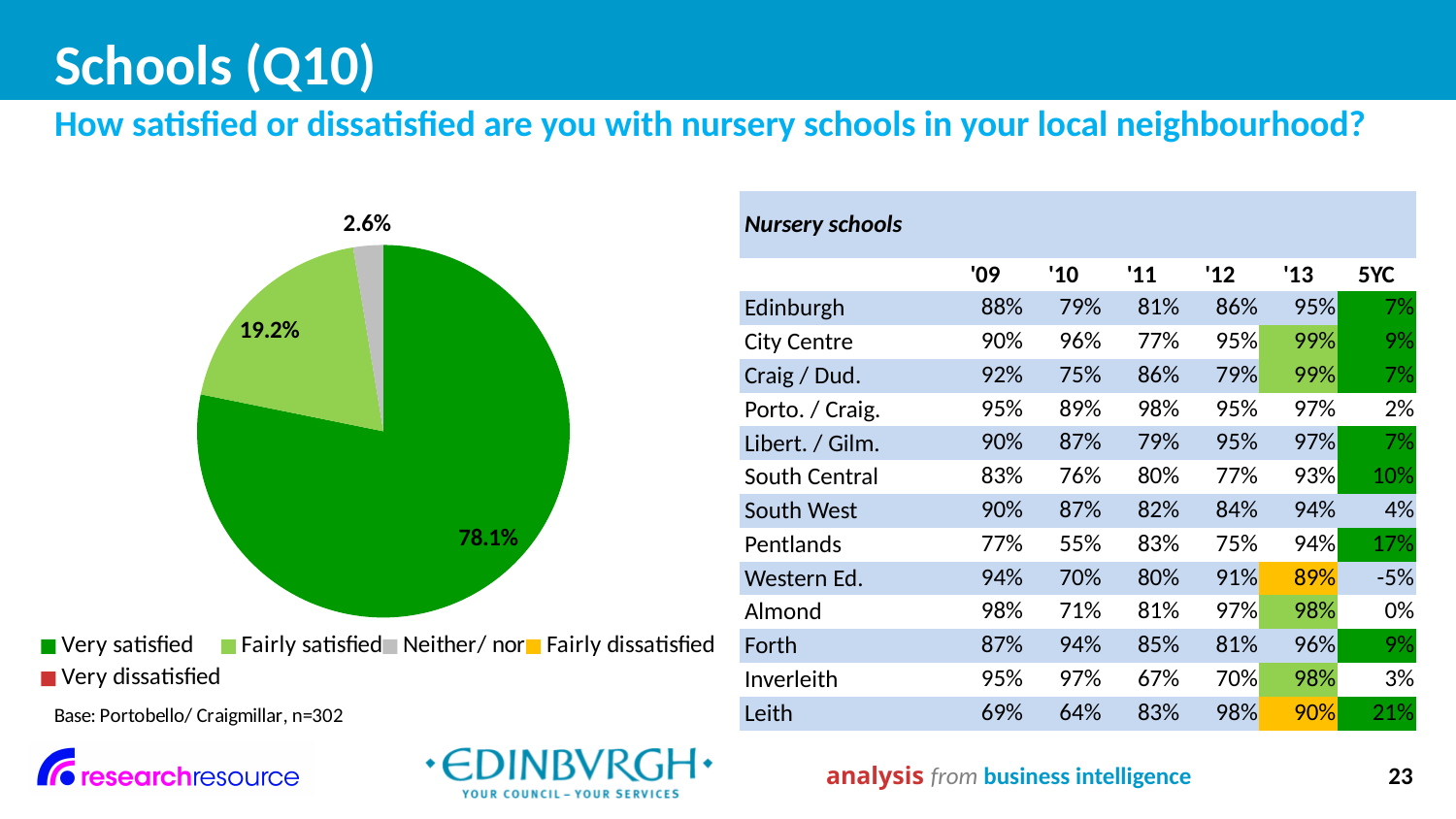
What percentage of respondents are 'Fairly satisfied' according to the pie chart? 19.2% Which is larger in the pie chart: 'Fairly satisfied' or 'Neither/ nor'? Fairly satisfied What is the base sample size stated below the pie chart? n=302 How many slices in the pie chart have a data label? 3 How many categories are listed in the pie chart's legend? 5 Which labelled slice of the pie chart is the smallest? Neither/ nor What percentage of respondents are 'Very satisfied' with nursery schools according to the pie chart? 78.1% What percentage is shown for 'Neither/ nor' in the pie chart? 2.6% Which category has the largest slice of the pie chart? Very satisfied What is the difference in percentage points between the 'Very satisfied' and 'Fairly satisfied' slices? 58.9 percentage points What kind of chart is shown on the slide? pie chart What colour is the 'Very satisfied' slice in the pie chart? dark green